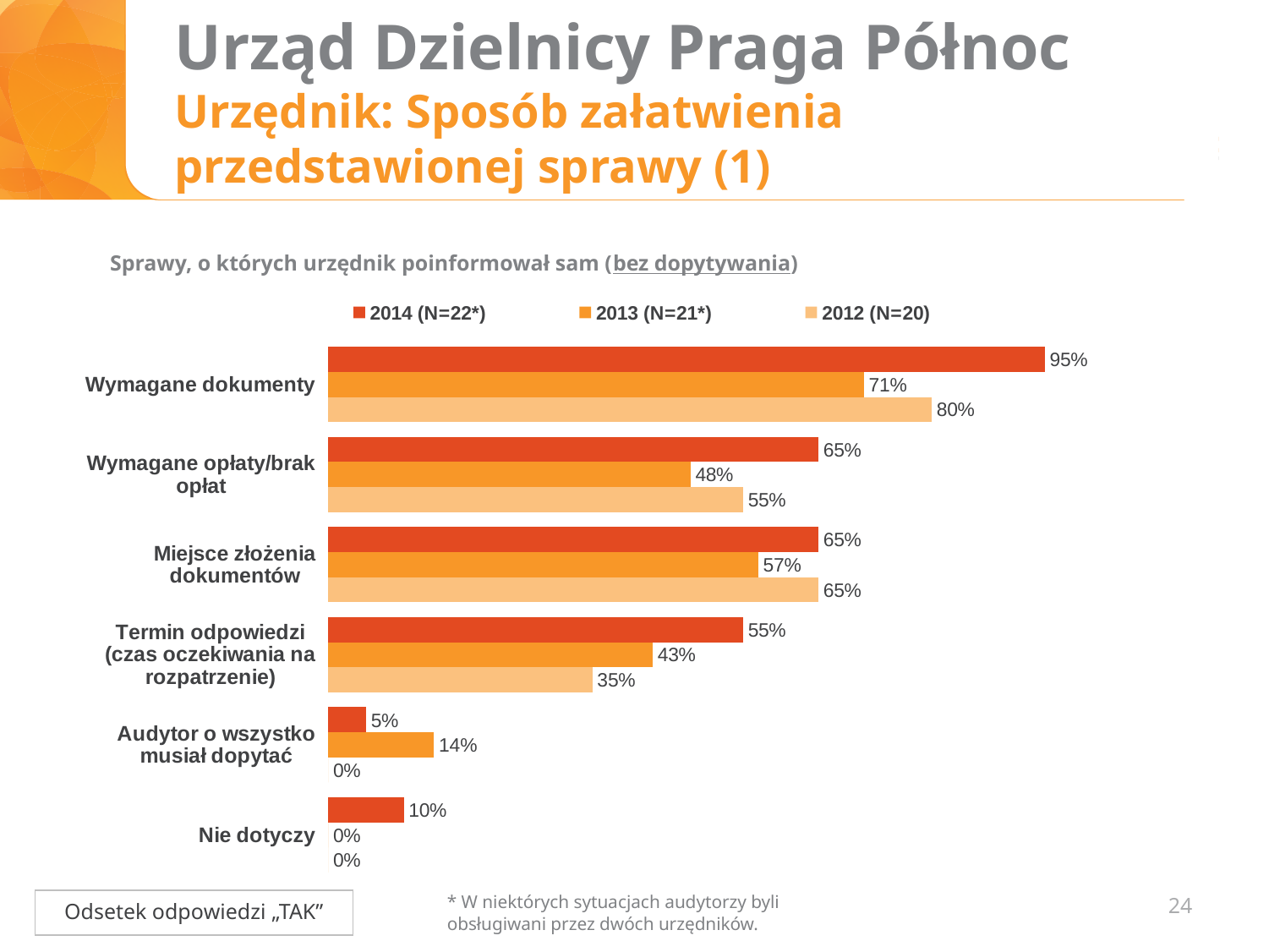
What is the value for "Termin odpowiedzi (czas oczekiwania na rozpatrzenie)" in the 2012 (N=20) series? 35% Which category has the highest value in the 2014 (N=22*) series? Wymagane dokumenty What kind of chart is shown on the slide? Bar chart What is the difference between the 2014 (N=22*) and 2013 (N=21*) values for "Wymagane dokumenty"? 24% How many series does the legend list? 3 Which category has the lowest value in the 2013 (N=21*) series? Nie dotyczy What is the value for "Wymagane opłaty/brak opłat" in the 2013 (N=21*) series? 48% What is the value for "Wymagane dokumenty" in the 2014 (N=22*) series? 95% For "Miejsce złożenia dokumentów", which is larger: the 2013 (N=21*) value or the 2012 (N=20) value? 2012 (N=20) What is the value for "Audytor o wszystko musiał dopytać" in the 2012 (N=20) series? 0% How many categories are shown on the chart? 6 What is the title of the chart? Sprawy, o których urzędnik poinformował sam (bez dopytywania)